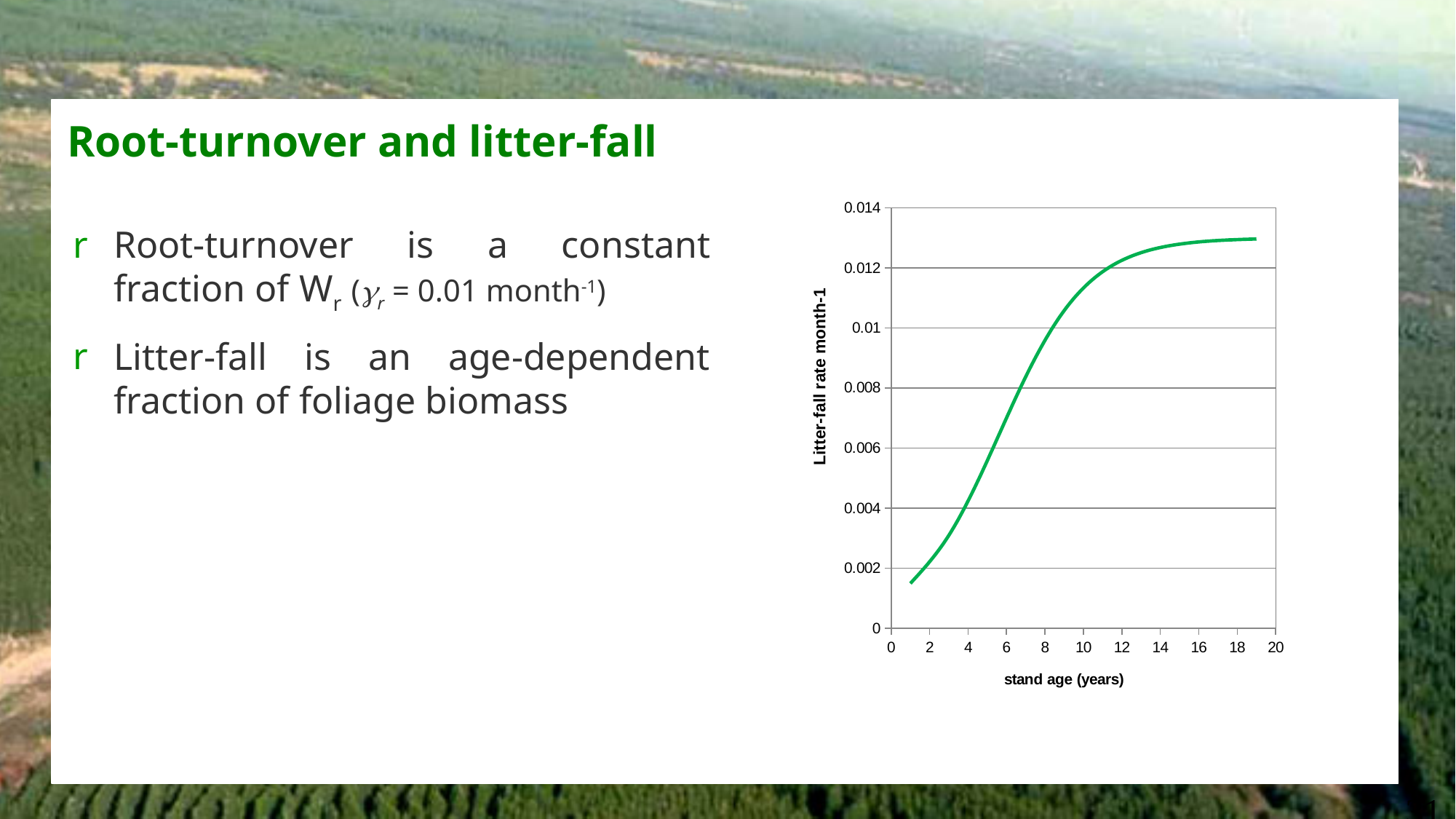
What kind of chart is shown on the slide? line chart What is the label of the x axis of the chart? stand age (years) Which is larger, the litter-fall rate at a stand age of 4 years or at 12 years? 12 years Is the litter-fall rate at a stand age of 6 years greater or less than 0.008? less Is the litter-fall rate at a stand age of 10 years greater or less than 0.01? greater Is the litter-fall rate at a stand age of 18 years greater or less than 0.014? less Does the litter-fall rate rise or fall as stand age increases? rise What is the label of the y axis of the chart? Litter-fall rate month-1